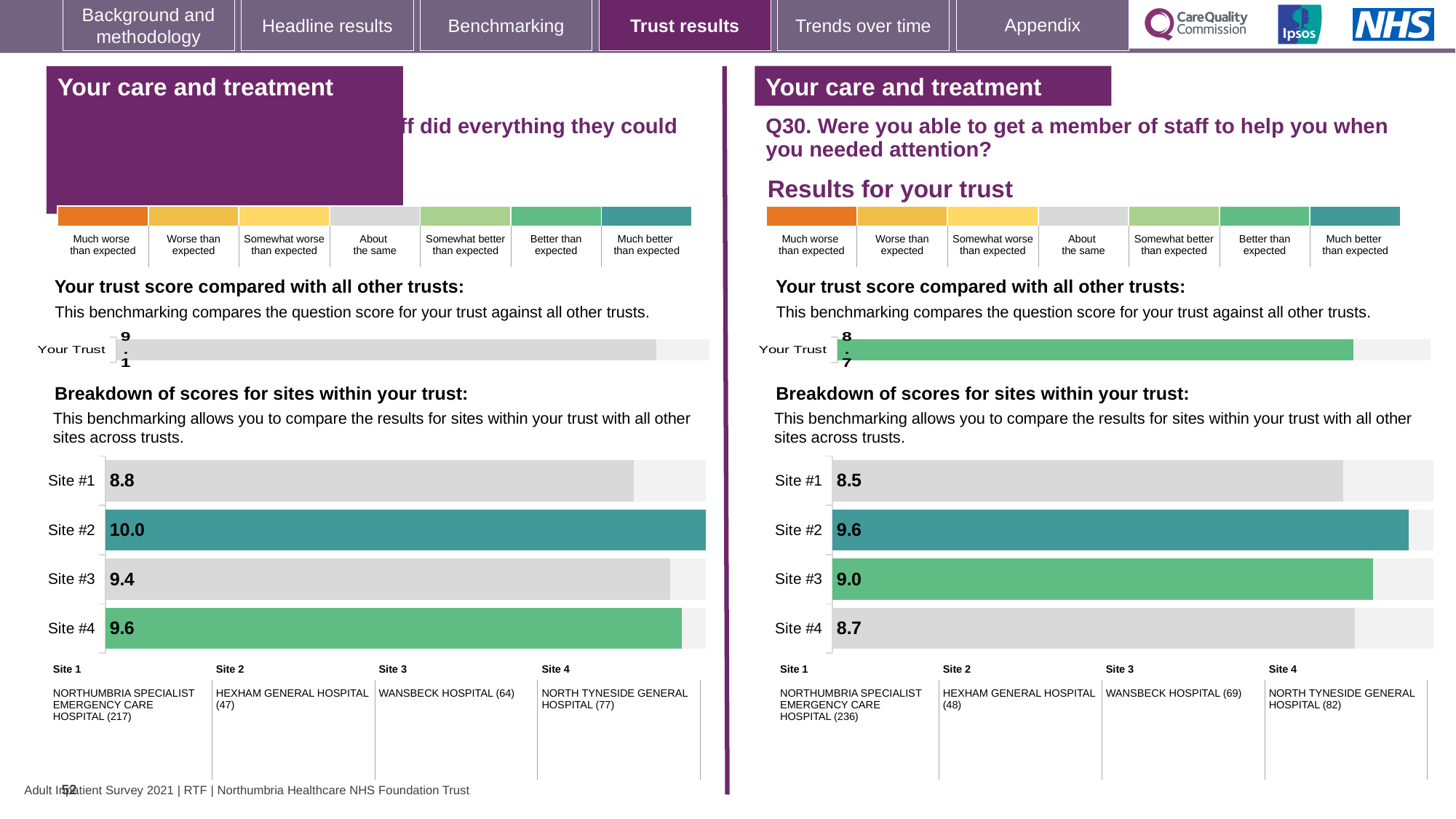
On the right-hand (Q30) 'Your trust score compared with all other trusts' chart, what is the score for Your Trust? 8.7 How many sites are shown on the right-hand (Q30) site breakdown chart? 4 What kind of chart is the left-hand site breakdown chart? Bar chart On the left-hand site breakdown chart, what is the difference between the scores for Site #2 and Site #1? 1.2 On the right-hand (Q30) site breakdown chart, what is the score for Site #2? 9.6 On the left-hand 'Your trust score compared with all other trusts' chart, what is the score for Your Trust? 9.1 On the right-hand (Q30) site breakdown chart, which has the larger score, Site #3 or Site #4? Site #3 On the left-hand site breakdown chart, what is the score for Site #3? 9.4 On the right-hand (Q30) site breakdown chart, which site has the lowest score? Site #1 On the left-hand site breakdown chart, which has the larger score, Site #1 or Site #4? Site #4 On the right-hand (Q30) site breakdown chart, what is the difference between the scores for Site #2 and Site #4? 0.9 On the left-hand site breakdown chart, which site has the highest score? Site #2